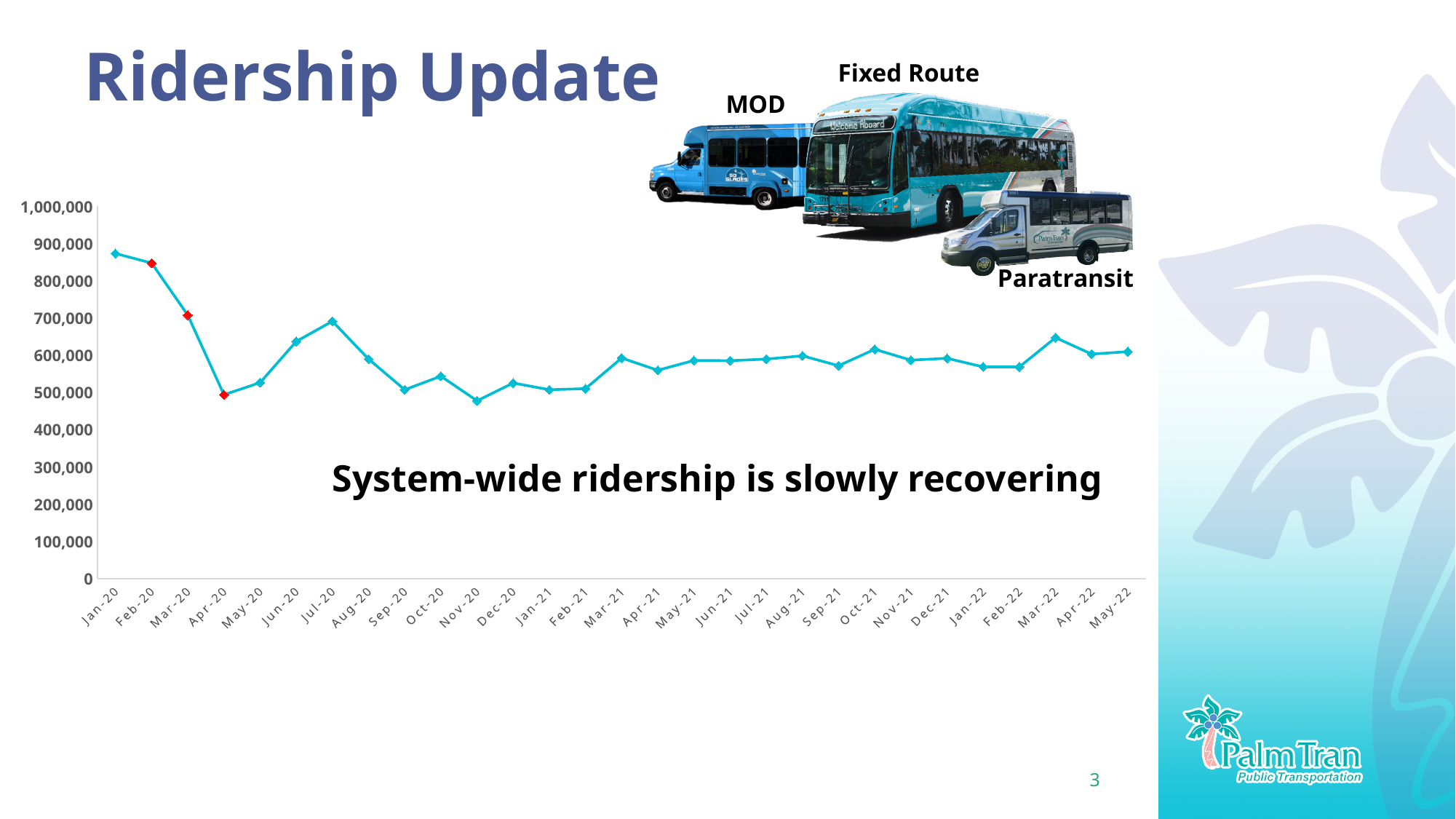
What kind of chart is shown on the slide? line chart Which is larger, the value for Jul-20 or the value for Sep-20? Jul-20 Is the value for Jan-20 greater or less than 800,000? greater Which month has the highest ridership value on the chart? Jan-20 Is the value for Mar-22 greater or less than 600,000? greater Is the value for Nov-20 greater or less than 600,000? less How many monthly data points are plotted on the chart? 29 What is the highest value shown on the chart's vertical axis? 1,000,000 Which is larger, the value for Jan-20 or the value for May-22? Jan-20 Do the values rise or fall from Jan-20 to Apr-20? fall